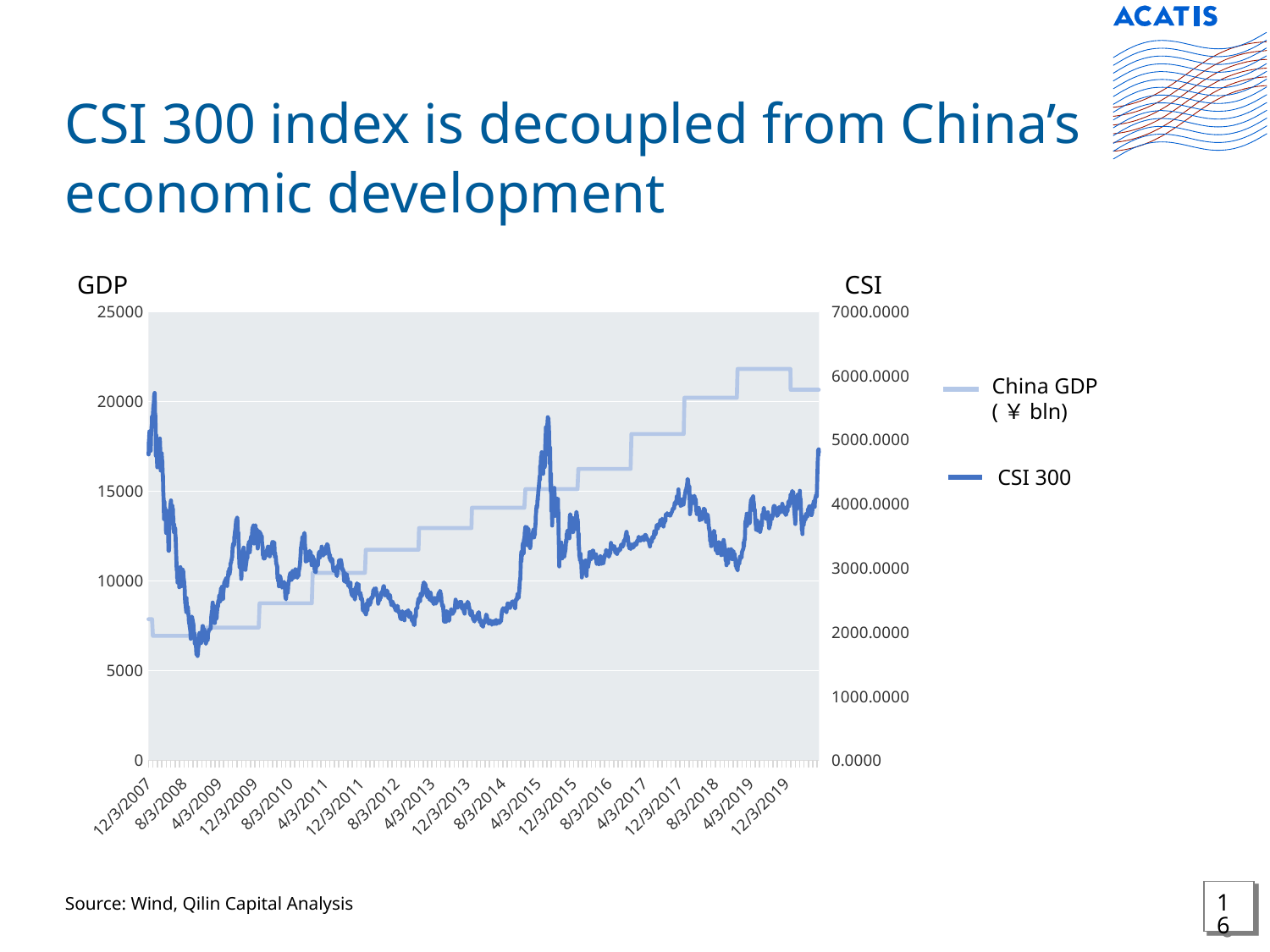
What are the two series named in the chart legend? China GDP (¥ bln) and CSI 300 What is the title of the left vertical axis of the chart? GDP Is the lowest CSI 300 value, reached around 4/3/2009, greater or less than 3000 on the right axis? less Does the China GDP series generally rise or fall from 12/3/2007 to 12/3/2019? rise How many series does the chart legend list? 2 Is the China GDP value around 4/3/2019 greater or less than 20000 on the left axis? greater What kind of chart is shown on the slide? line chart Is the China GDP value around 8/3/2014 greater or less than 15000 on the left axis? less Does the CSI 300 series rise or fall between 12/3/2007 and 4/3/2009? fall